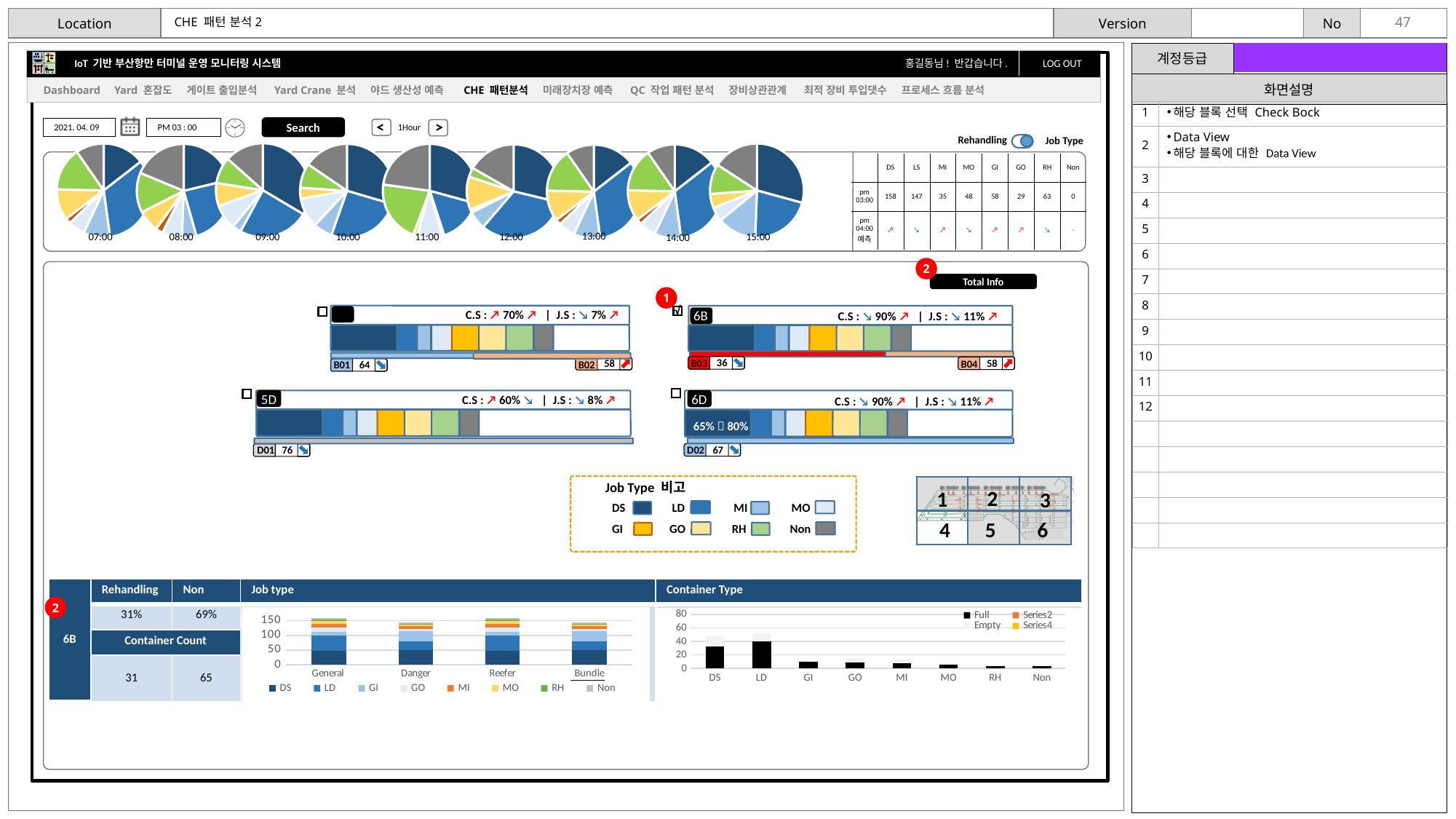
In the "Job type" chart, which has the taller stacked bar, General or Bundle? General How many series does the legend of the "Job type" chart list? 8 How many pie charts are shown in the row of hourly charts at the top of the slide? 9 What kind of chart is the "Job type" chart at the bottom of the slide? bar chart In the "Container Type" chart, is the value for GI greater or less than 20? less How many categories are shown on the x axis of the "Job type" chart? 4 What kind of chart is the "Container Type" chart at the bottom right of the slide? bar chart In the "Job type" chart, is the total stacked value for General greater or less than 100? greater In the "Container Type" chart, which category has the highest bar? LD In the "Job type" chart, is the total stacked value for Danger greater or less than 150? less How many categories are shown on the x axis of the "Container Type" chart? 8 How many entries does the legend of the "Container Type" chart list? 4